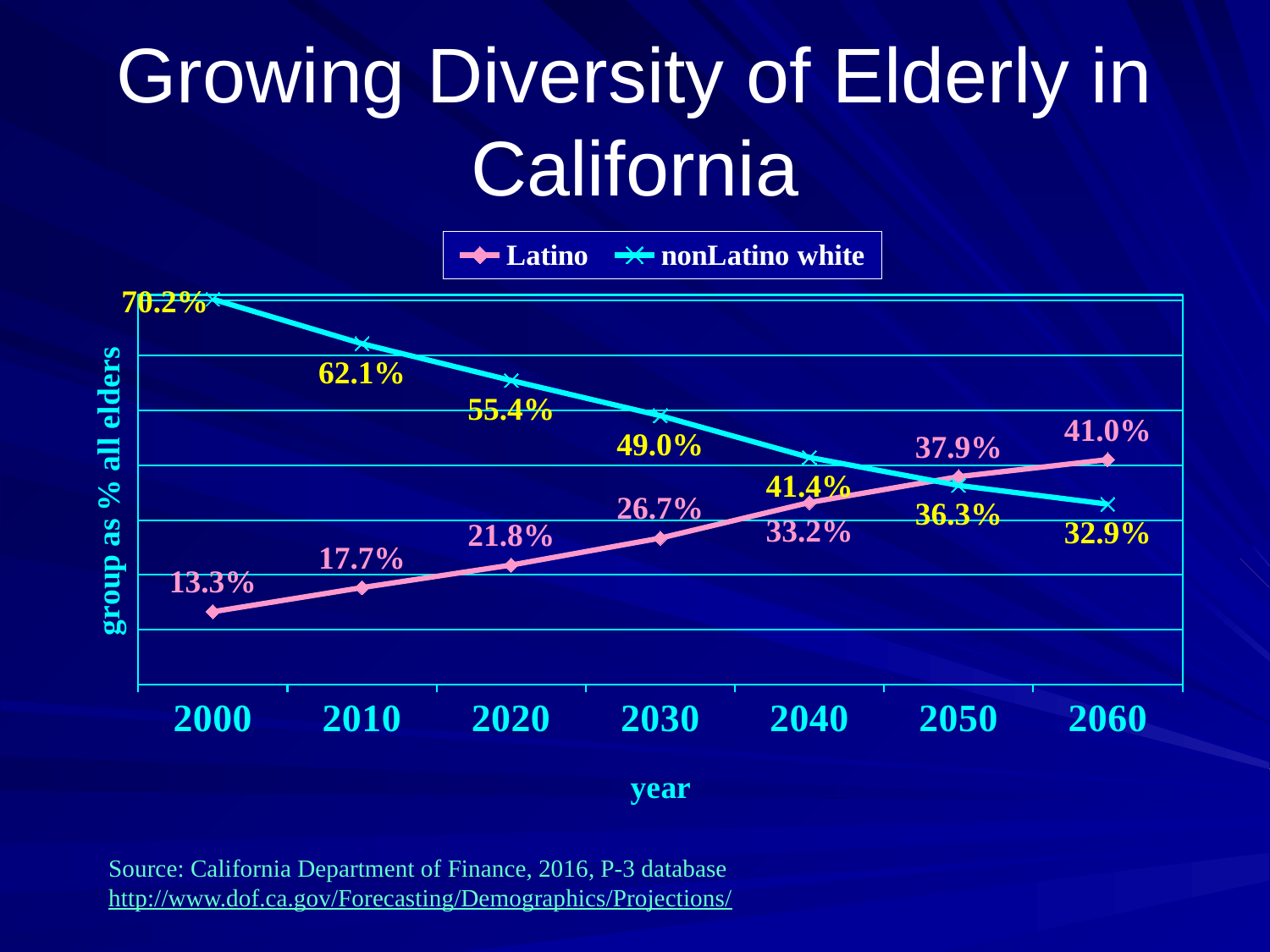
In which year is the Latino share lowest? 2000 What is the Latino value in 2050? 37.9% How many series does the legend list? 2 Does the nonLatino white series rise or fall from 2000 to 2060? fall In which year is the nonLatino white share highest? 2000 What is the nonLatino white share of all elders in 2030? 49.0% What is the Latino share of all elders in 2000? 13.3% In 2060, which group has the larger share of all elders, Latino or nonLatino white? Latino What is the difference between the nonLatino white and Latino values in 2000? 56.9% What type of chart is shown on the slide? line chart What is the label on the y axis? group as % all elders How many years are plotted along the x axis? 7